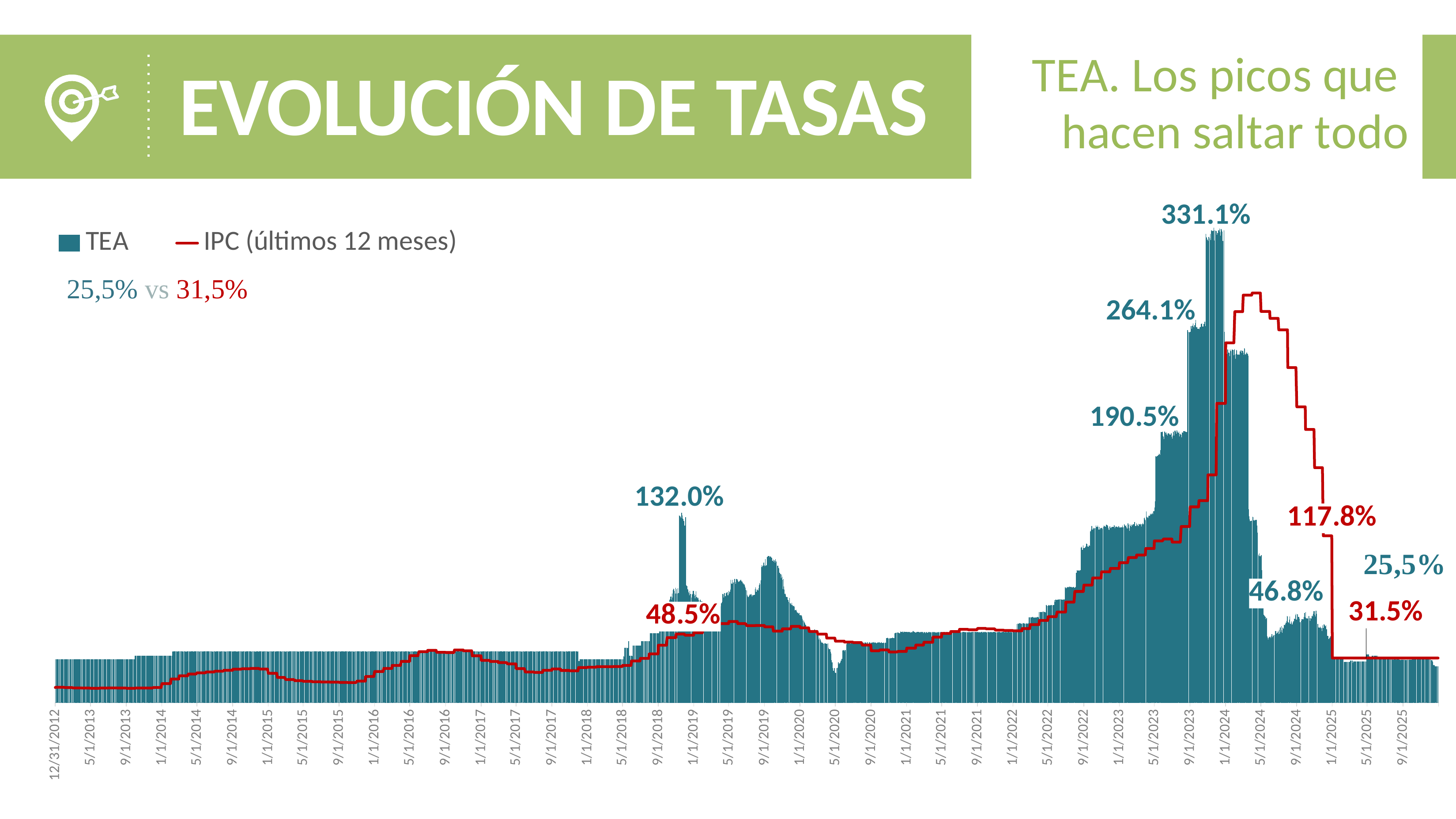
How many series does the legend list? 2 At the right end of the chart, which is larger: the latest TEA value or the latest IPC value? IPC (31.5%) What is the title of the chart's slide header? EVOLUCIÓN DE TASAS Does the TEA series rise or fall from its 2023 peak to the end of 2025? Fall What is the highest labeled TEA peak value? 331.1% What is the most recent labeled TEA value at the right end of the chart? 25,5% What kind of chart is shown? Bar chart with a line series What is the most recent labeled IPC value at the right end of the chart? 31.5% What is the labeled TEA peak value around late 2018? 132.0% What is the labeled IPC value shown near the 2019 period? 48.5% What is the difference between the 331.1% TEA peak and the 264.1% TEA peak? 67.0% What are the two series named in the legend? TEA and IPC (últimos 12 meses)